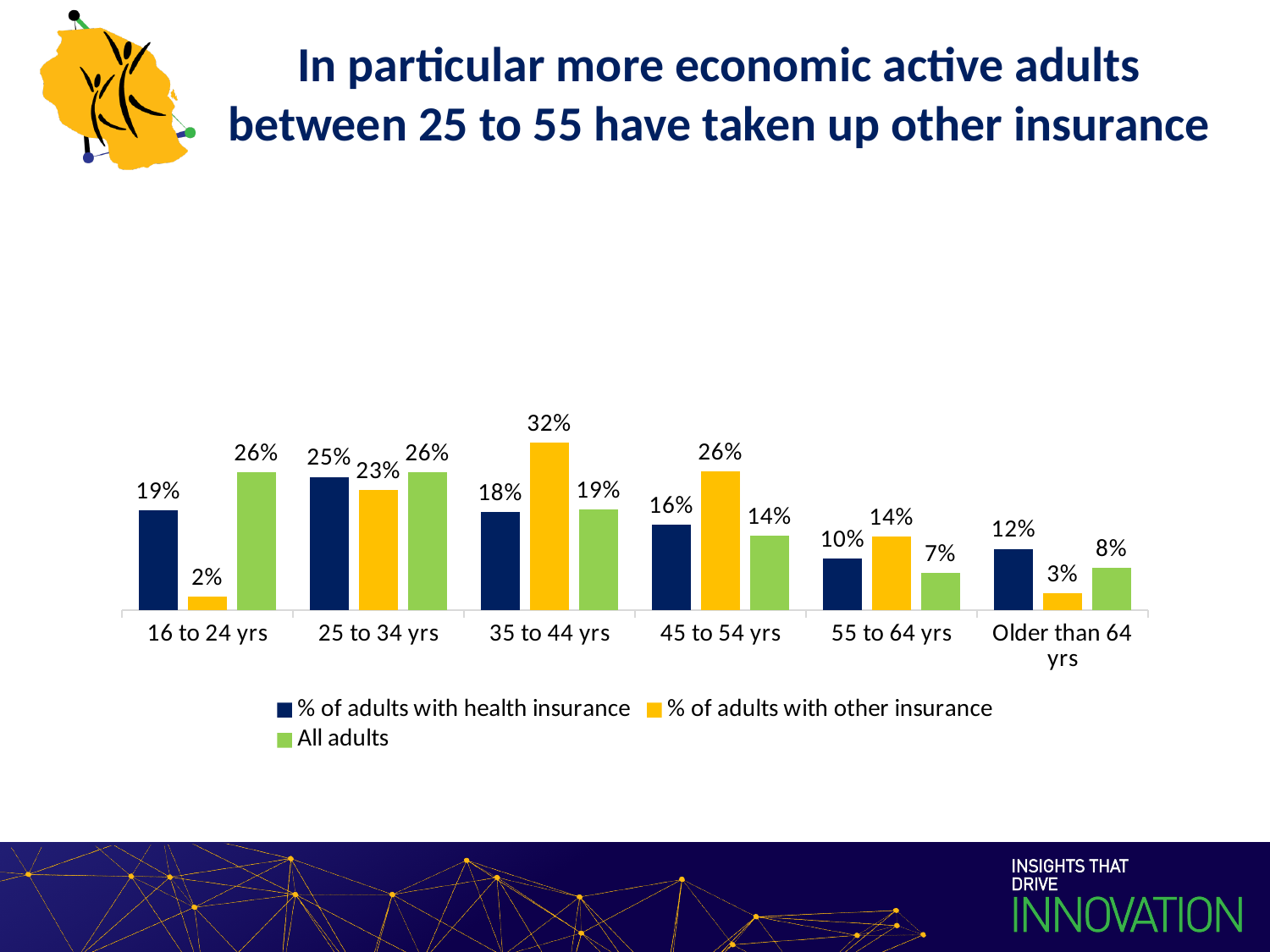
Which age category has the lowest value for '% of adults with health insurance'? 55 to 64 yrs Which age category has the highest value for '% of adults with other insurance'? 35 to 44 yrs What is the value for 'All adults' in the 55 to 64 yrs category? 7% What kind of chart is shown on the slide? bar chart What is the difference between '% of adults with other insurance' and '% of adults with health insurance' in the 35 to 44 yrs category? 14% How many age categories are shown on the x axis? 6 In the 16 to 24 yrs category, which is larger: '% of adults with health insurance' or '% of adults with other insurance'? % of adults with health insurance Does the '% of adults with health insurance' series rise or fall from 25 to 34 yrs to 55 to 64 yrs? fall How many series does the legend list? 3 What is the value for '% of adults with other insurance' in the 35 to 44 yrs category? 32% What colour are the bars for the 'All adults' series? green What is the value for '% of adults with health insurance' in the 16 to 24 yrs category? 19%